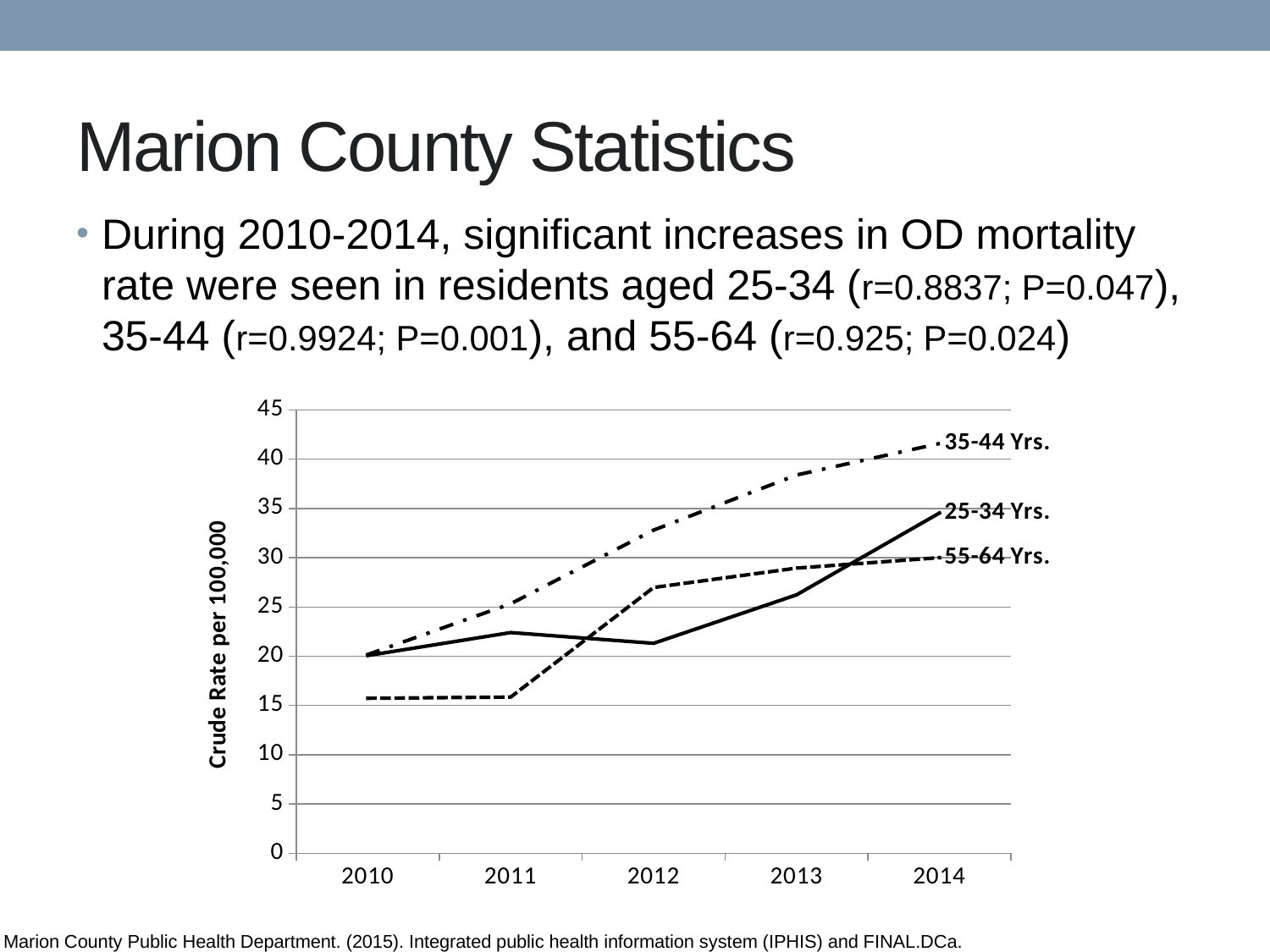
Is the value for 35-44 Yrs. in 2012 greater or less than 25? greater Is the value for 55-64 Yrs. in 2010 greater or less than 20? less Is the value for 25-34 Yrs. in 2014 greater or less than 30? greater How many series (age groups) are plotted on the chart? 3 Which age group has the lowest crude rate in 2011? 55-64 Yrs. How many years are shown along the x axis of the chart? 5 Does the line for 35-44 Yrs. rise or fall from 2010 to 2014? rise Which age group has the highest crude rate in 2014? 35-44 Yrs. In 2012, which is larger: the value for 55-64 Yrs. or the value for 25-34 Yrs.? 55-64 Yrs. What kind of chart is shown on the slide? line chart What is the title of the y axis on the chart? Crude Rate per 100,000